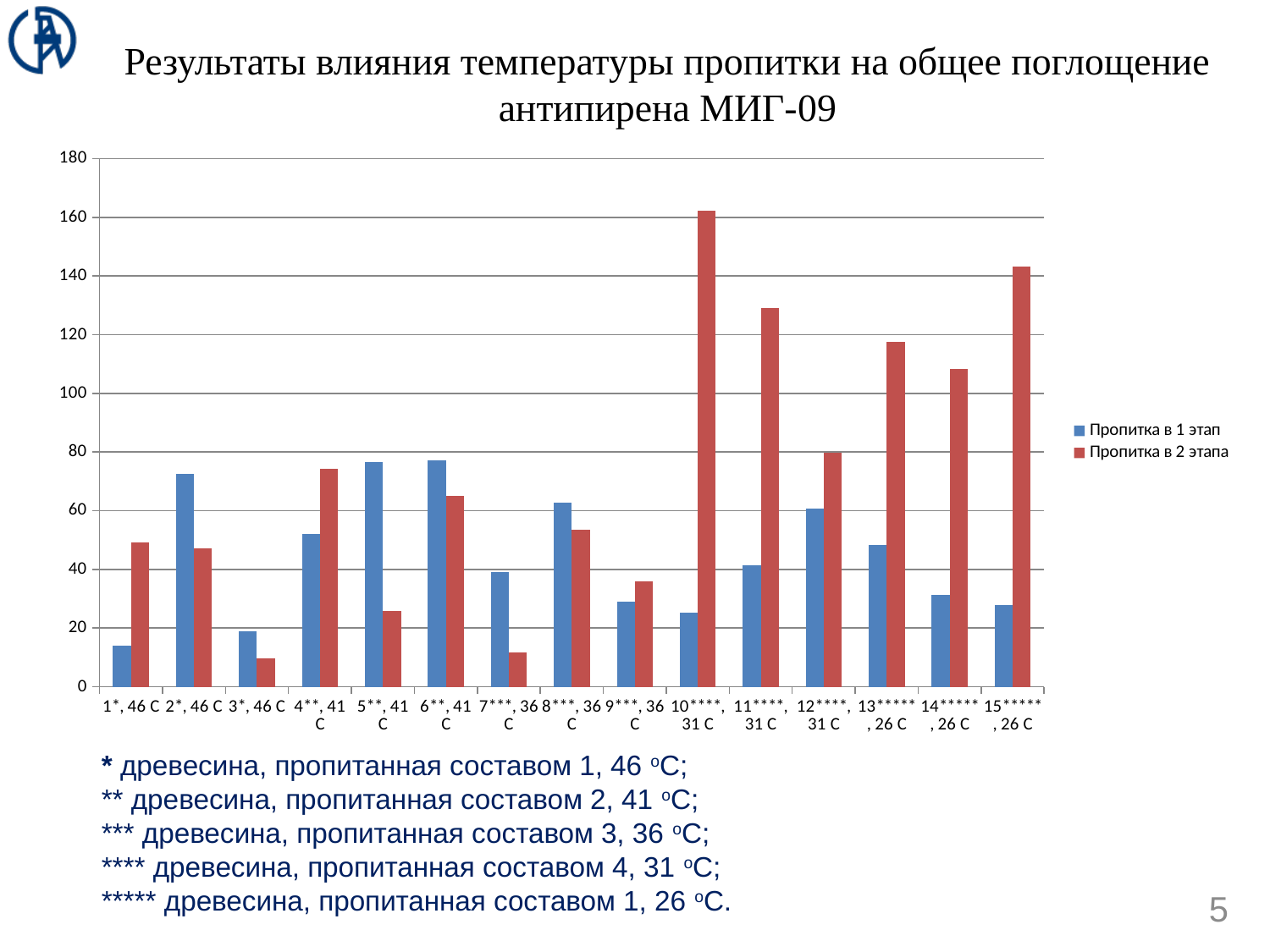
Is the value of "Пропитка в 1 этап" for 2*, 46 C greater or less than 60? greater Which series is shown in red in the chart? Пропитка в 2 этапа Is the value of "Пропитка в 2 этапа" for 15*****, 26 C greater or less than 120? greater Which category has the lowest value for the series "Пропитка в 2 этапа"? 3*, 46 C How many series does the legend list? 2 Is the value of "Пропитка в 2 этапа" for 3*, 46 C greater or less than 20? less For category 13*****, 26 C, which series has the larger value: "Пропитка в 1 этап" or "Пропитка в 2 этапа"? Пропитка в 2 этапа Which category has the highest value for the series "Пропитка в 2 этапа"? 10****, 31 C What kind of chart is shown on the slide? bar chart For category 5**, 41 C, which series has the larger value: "Пропитка в 1 этап" or "Пропитка в 2 этапа"? Пропитка в 1 этап How many categories are shown on the x axis? 15